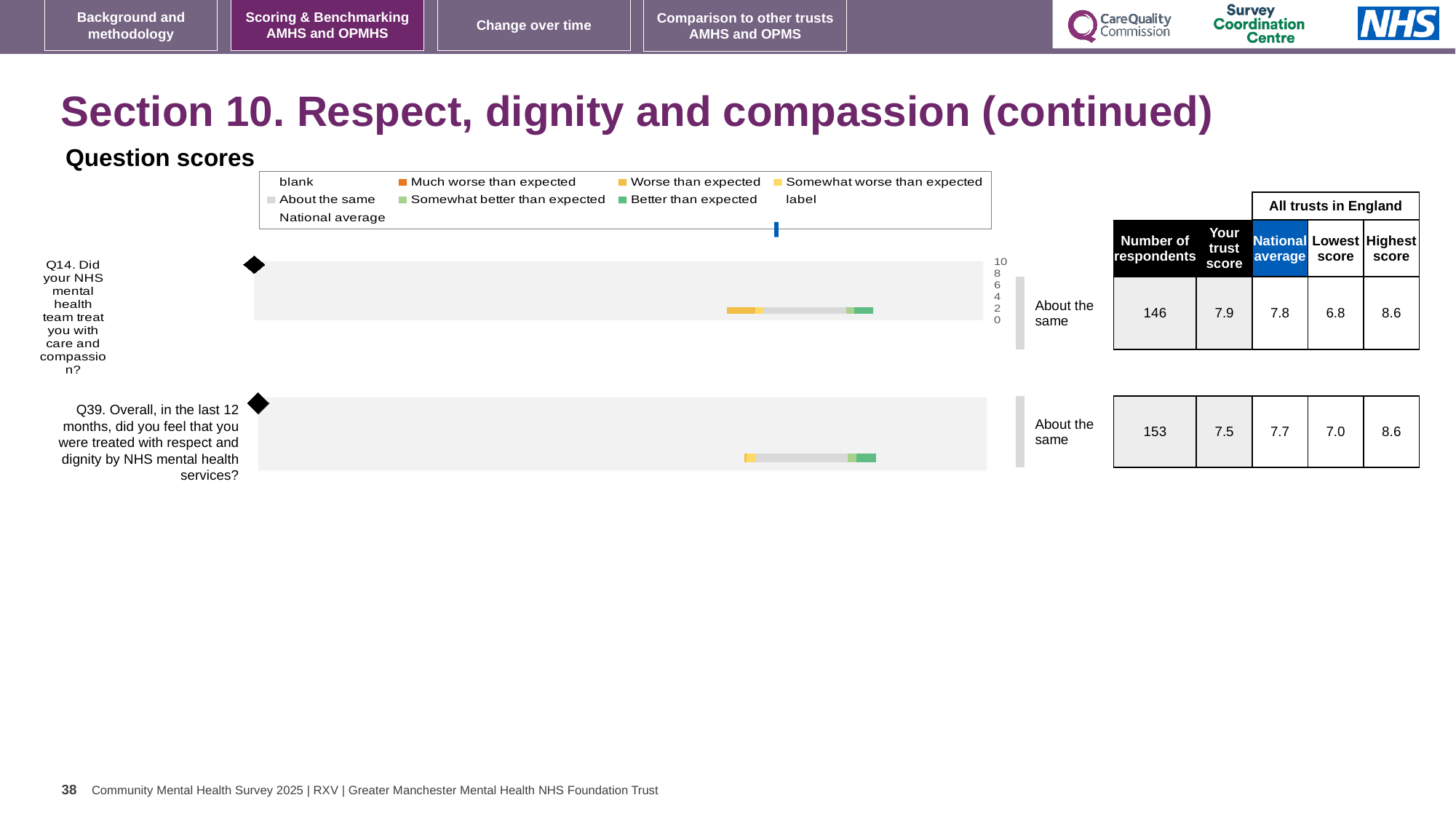
What is the national average score for Q14? 7.8 How many respondents answered Q39? 153 Which question has the higher trust score, Q14 or Q39? Q14 How many respondents answered Q14? 146 What benchmark category is shown next to the Q14 chart? About the same What kind of chart is used to show the question scores? Bar chart What is the trust score for Q14 (Did your NHS mental health team treat you with care and compassion?)? 7.9 By how much does the national average exceed the trust score for Q39? 0.2 What is the highest score among all trusts in England for Q39? 8.6 What is the difference between the highest score and the lowest score for Q14? 1.8 How many questions are charted on this slide? 2 What is the trust score for Q39 (treated with respect and dignity by NHS mental health services)? 7.5